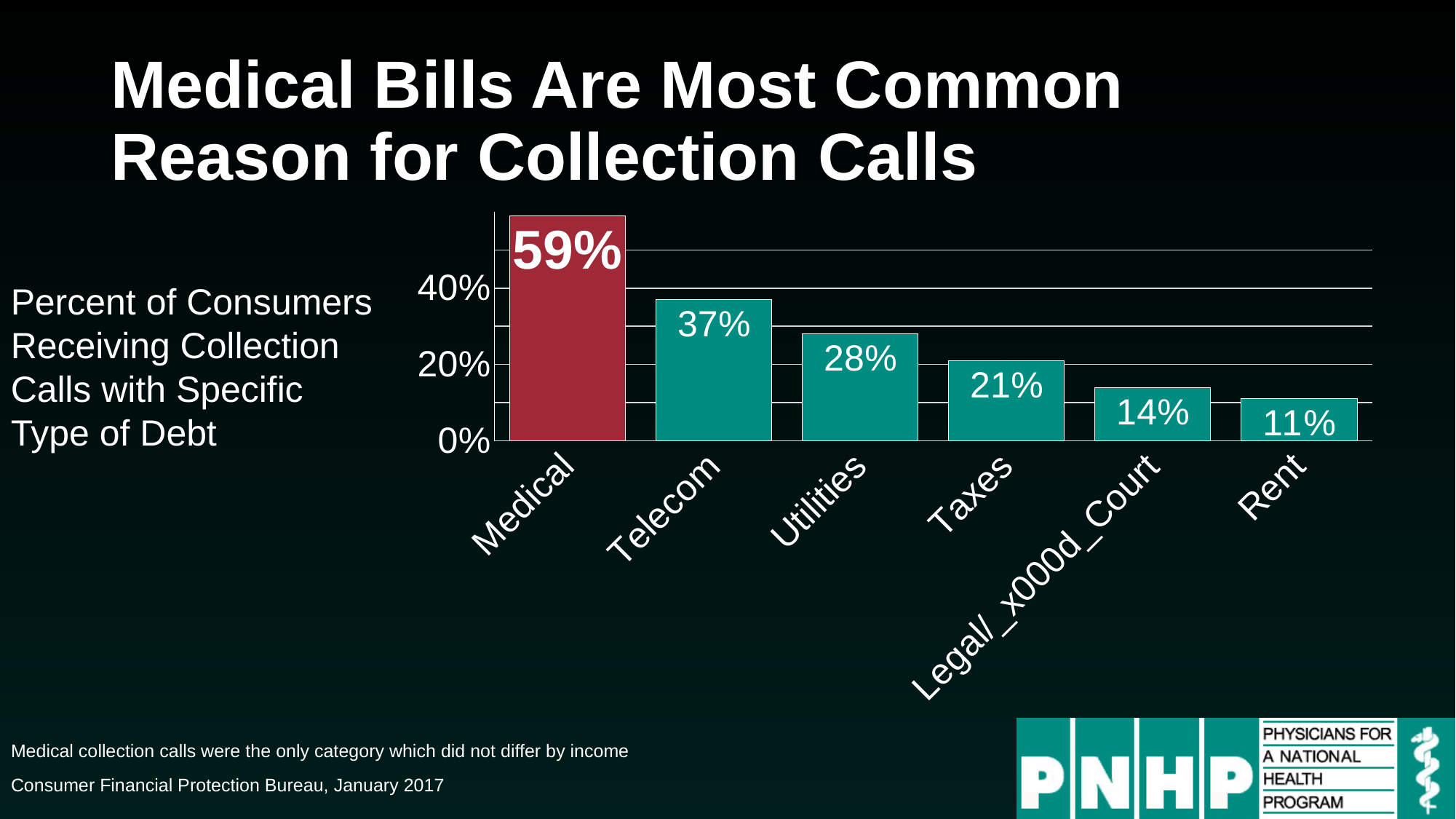
How many types of debt are shown in the chart? 6 Which is larger, the value for Utilities or the value for Taxes? Utilities What is the value shown for Telecom? 37% Which bar is shown in a different colour (red) from the others? Medical What kind of chart is shown on the slide? Bar chart What is the value shown for Rent? 11% What is the difference in percentage points between Taxes and Rent? 10 Which type of debt has the highest percentage of consumers receiving collection calls? Medical What is the value shown for Utilities? 28% What percent of consumers received collection calls for medical debt? 59% Which type of debt has the lowest percentage of consumers receiving collection calls? Rent What is the difference in percentage points between Medical and Telecom? 22